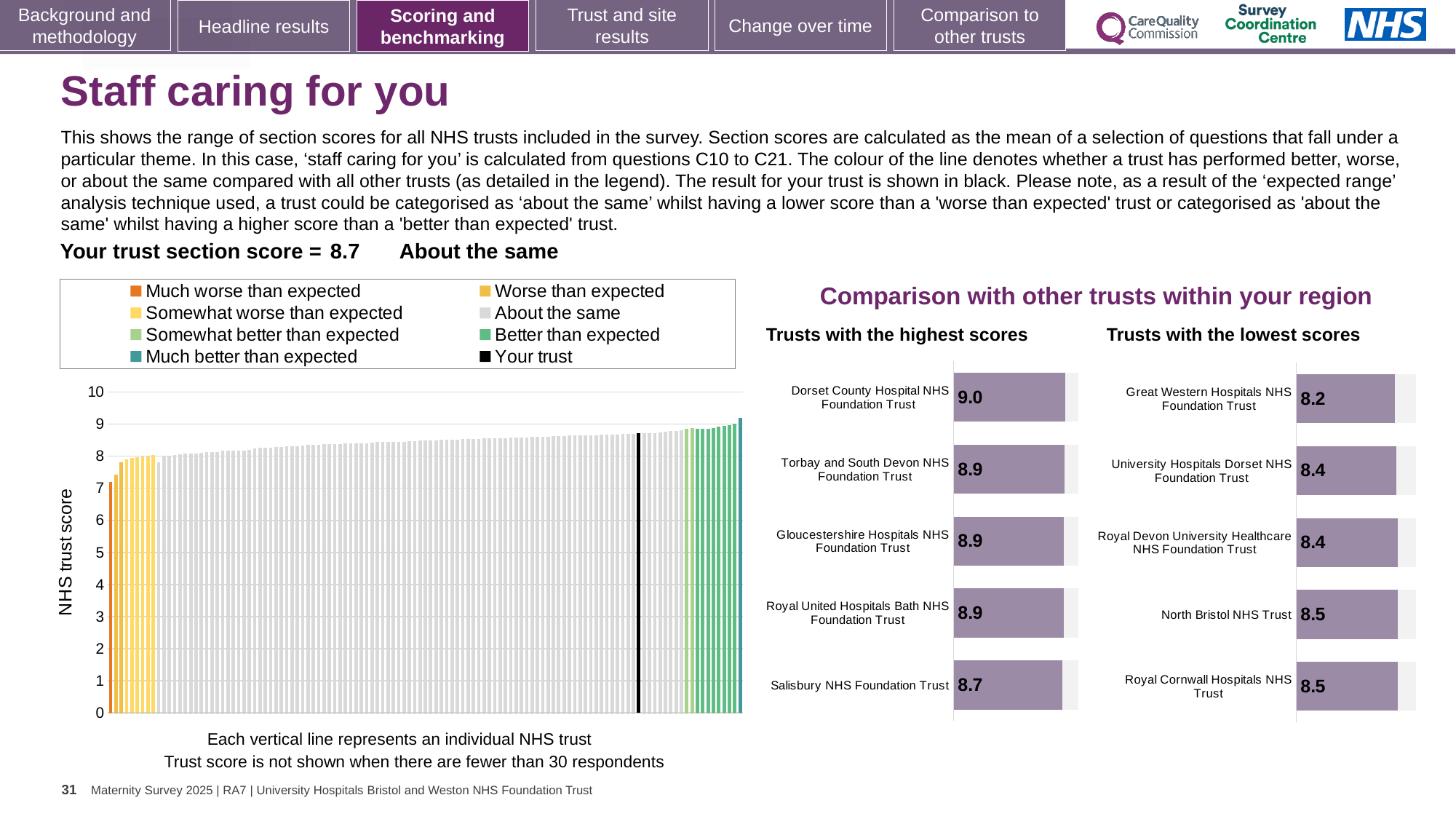
In the 'Trusts with the lowest scores' chart, which trust has the lowest score? Great Western Hospitals NHS Foundation Trust In the 'Trusts with the highest scores' chart, what is the difference between the scores of Dorset County Hospital NHS Foundation Trust and Salisbury NHS Foundation Trust? 0.3 In the 'Trusts with the lowest scores' chart, what is the score for North Bristol NHS Trust? 8.5 What kind of chart is the large chart on the left showing NHS trust scores? Bar chart In the 'Trusts with the highest scores' chart, which trust has the highest score? Dorset County Hospital NHS Foundation Trust In the 'Trusts with the lowest scores' chart, what is the score for Great Western Hospitals NHS Foundation Trust? 8.2 In the 'Trusts with the highest scores' chart, what is the score for Dorset County Hospital NHS Foundation Trust? 9.0 In the 'Trusts with the lowest scores' chart, which has the larger score: Royal Cornwall Hospitals NHS Trust or Great Western Hospitals NHS Foundation Trust? Royal Cornwall Hospitals NHS Trust In the 'Trusts with the lowest scores' chart, how many trusts are shown? 5 In the large chart on the left, is the value for the black 'Your trust' bar greater or less than 8? greater In the 'Trusts with the highest scores' chart, what is the score for Salisbury NHS Foundation Trust? 8.7 In the large chart on the left showing all NHS trusts, how many entries does the legend list? 8